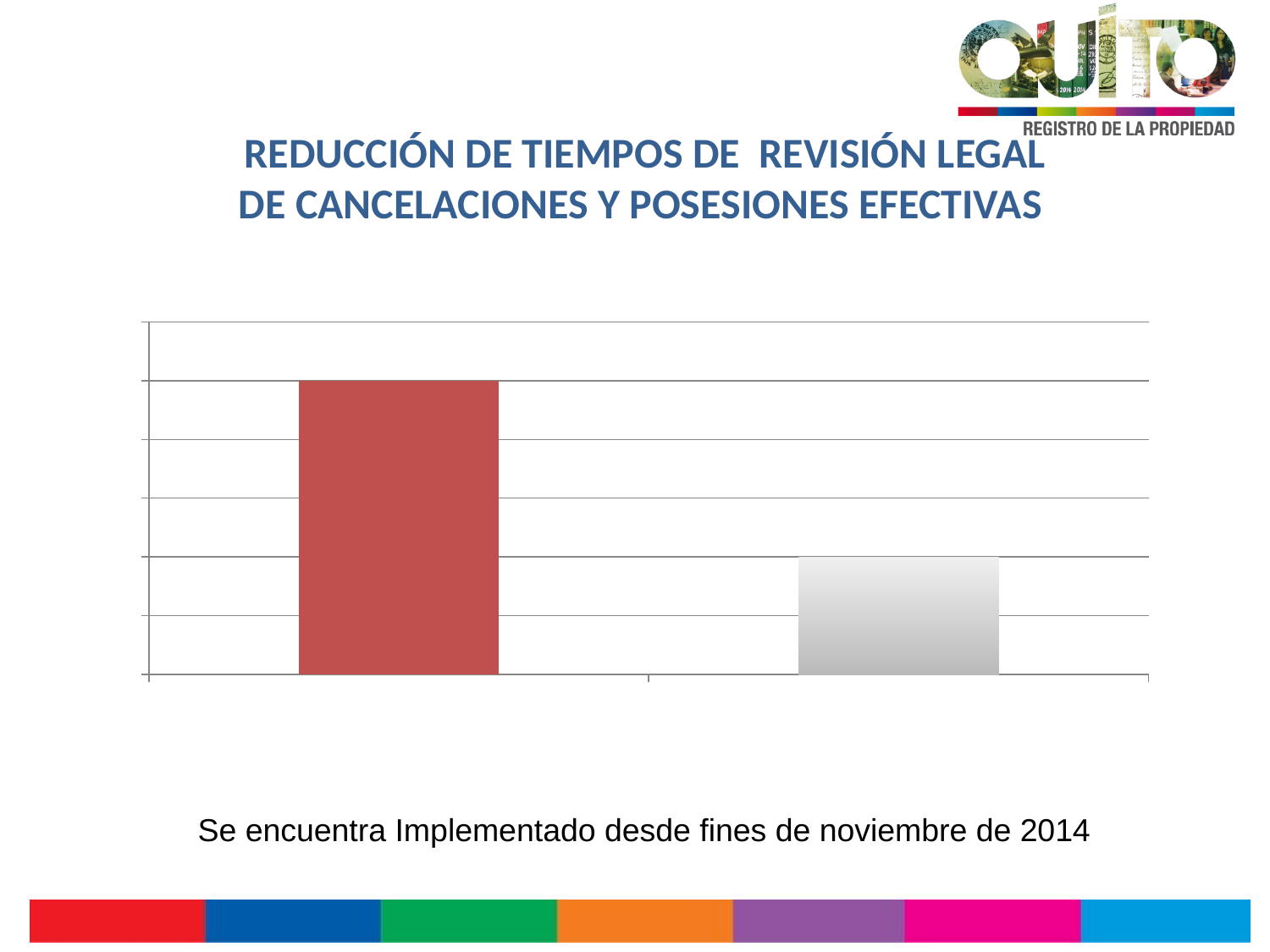
How many bars are plotted in the chart? 2 What colour is the left bar in the chart? red Which bar is taller, the red bar on the left or the grey bar on the right? the red bar on the left Which bar in the chart is the shortest? the grey bar on the right What kind of chart is shown on the slide? bar chart What is the title shown above the chart? REDUCCIÓN DE TIEMPOS DE REVISIÓN LEGAL DE CANCELACIONES Y POSESIONES EFECTIVAS Which bar in the chart is the tallest? the red bar on the left